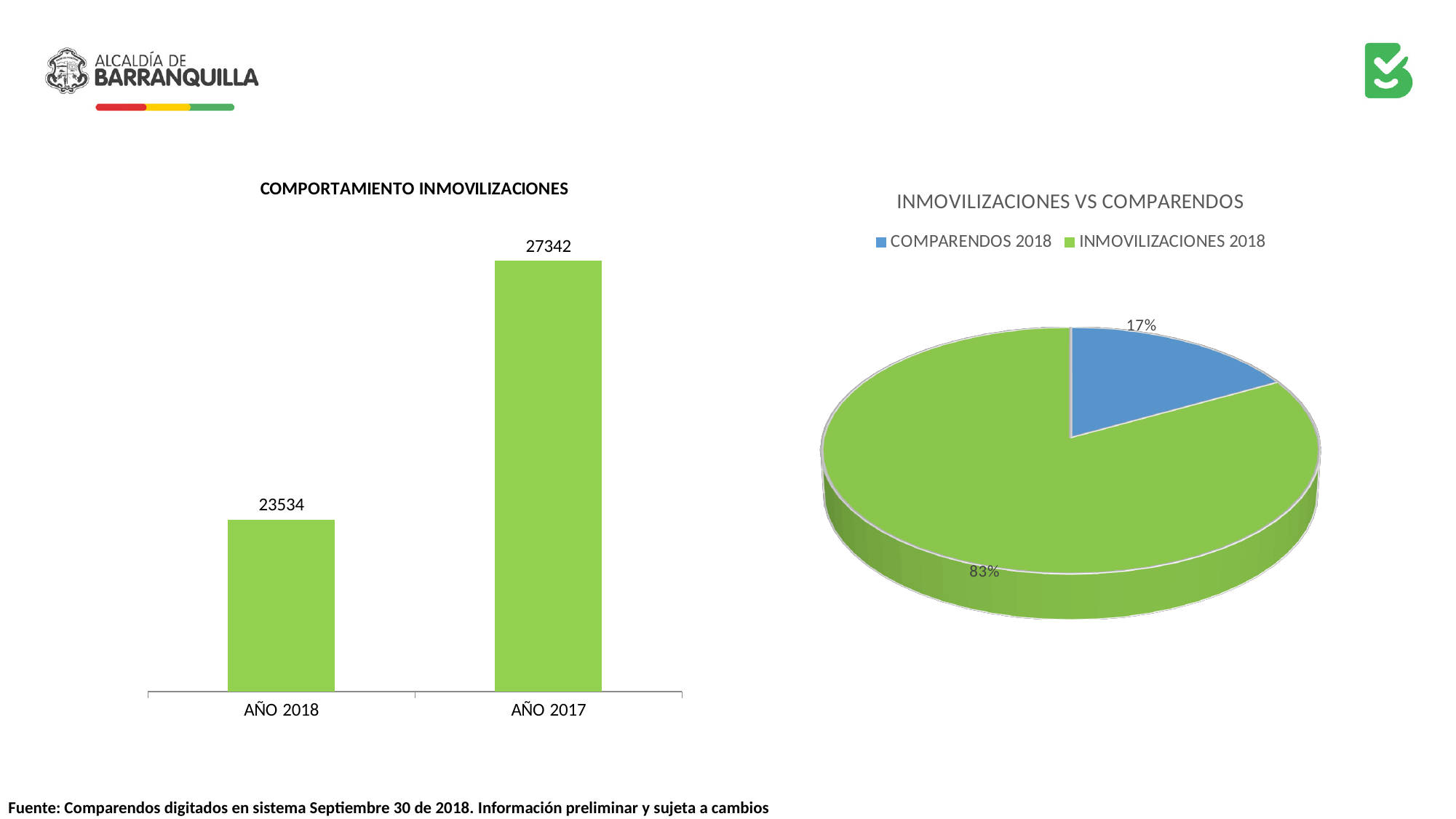
In the 'COMPORTAMIENTO INMOVILIZACIONES' chart, which year has the lower value? AÑO 2018 In the 'INMOVILIZACIONES VS COMPARENDOS' chart, how many entries does the legend list? 2 In the 'COMPORTAMIENTO INMOVILIZACIONES' chart, how many categories are shown? 2 In the 'COMPORTAMIENTO INMOVILIZACIONES' chart, what is the value for AÑO 2017? 27342 In the 'INMOVILIZACIONES VS COMPARENDOS' chart, which slice is larger? INMOVILIZACIONES 2018 In the 'COMPORTAMIENTO INMOVILIZACIONES' chart, what is the difference between the AÑO 2017 and AÑO 2018 values? 3808 What kind of chart is 'INMOVILIZACIONES VS COMPARENDOS'? Pie chart In the 'COMPORTAMIENTO INMOVILIZACIONES' chart, which year has the higher value? AÑO 2017 In the 'INMOVILIZACIONES VS COMPARENDOS' chart, what share does INMOVILIZACIONES 2018 have? 83% What kind of chart is 'COMPORTAMIENTO INMOVILIZACIONES'? Bar chart In the 'COMPORTAMIENTO INMOVILIZACIONES' chart, what is the value for AÑO 2018? 23534 In the 'INMOVILIZACIONES VS COMPARENDOS' chart, what share does COMPARENDOS 2018 have? 17%